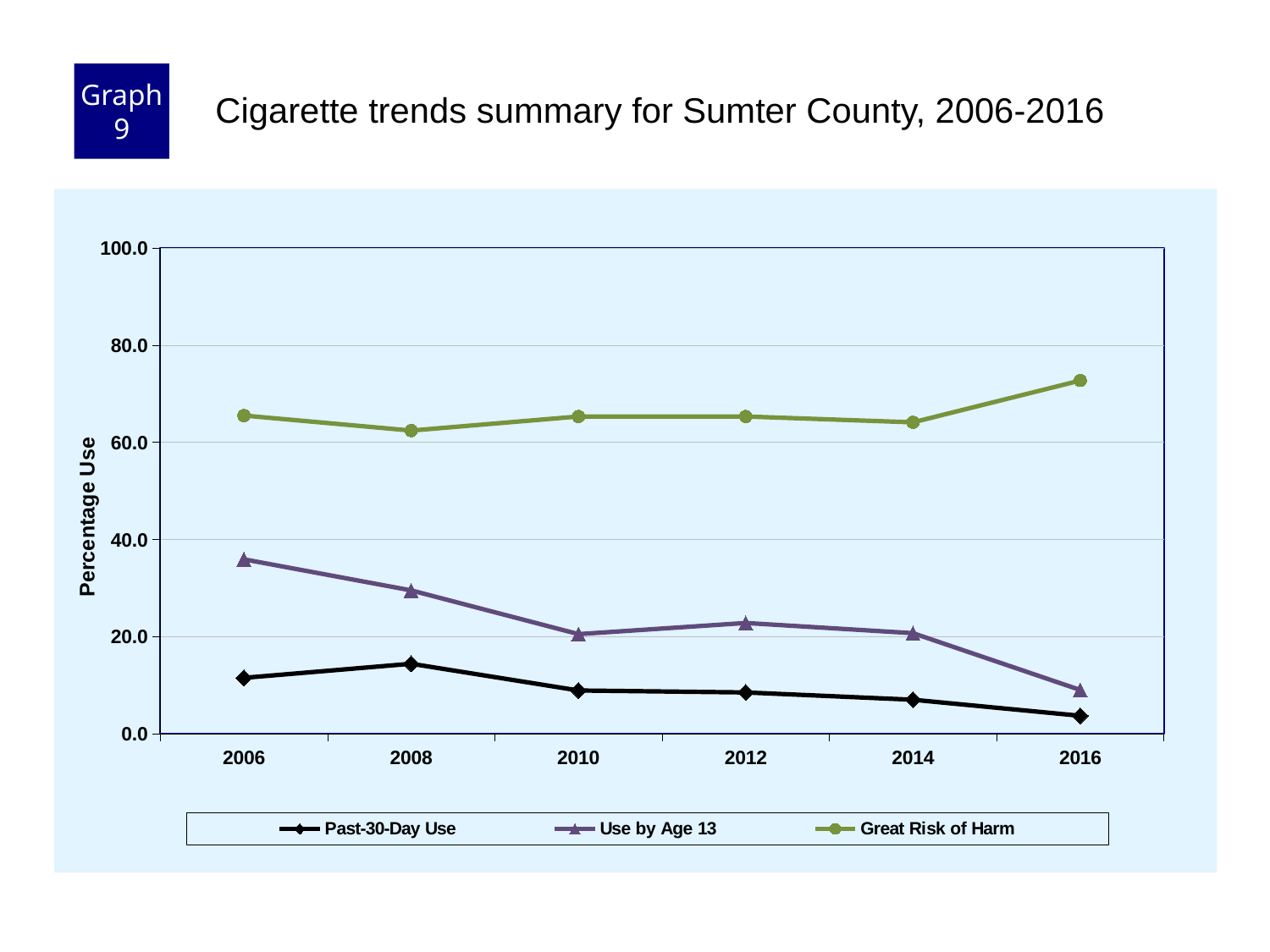
How many years are plotted along the x axis? 6 In which year is the Use by Age 13 series at its lowest? 2016 Is the value for Great Risk of Harm in 2016 greater or less than 80.0? less In which year is the Past-30-Day Use series at its lowest? 2016 In which year is the Past-30-Day Use series at its highest? 2008 In which year is the Great Risk of Harm series at its highest? 2016 What is the label on the y axis? Percentage Use In which year is the Use by Age 13 series at its highest? 2006 How many series does the legend list? 3 Is the value for Use by Age 13 in 2006 greater or less than 40.0? less Which is larger: Use by Age 13 in 2006 or Use by Age 13 in 2016? 2006 What kind of chart is shown on the slide? line chart